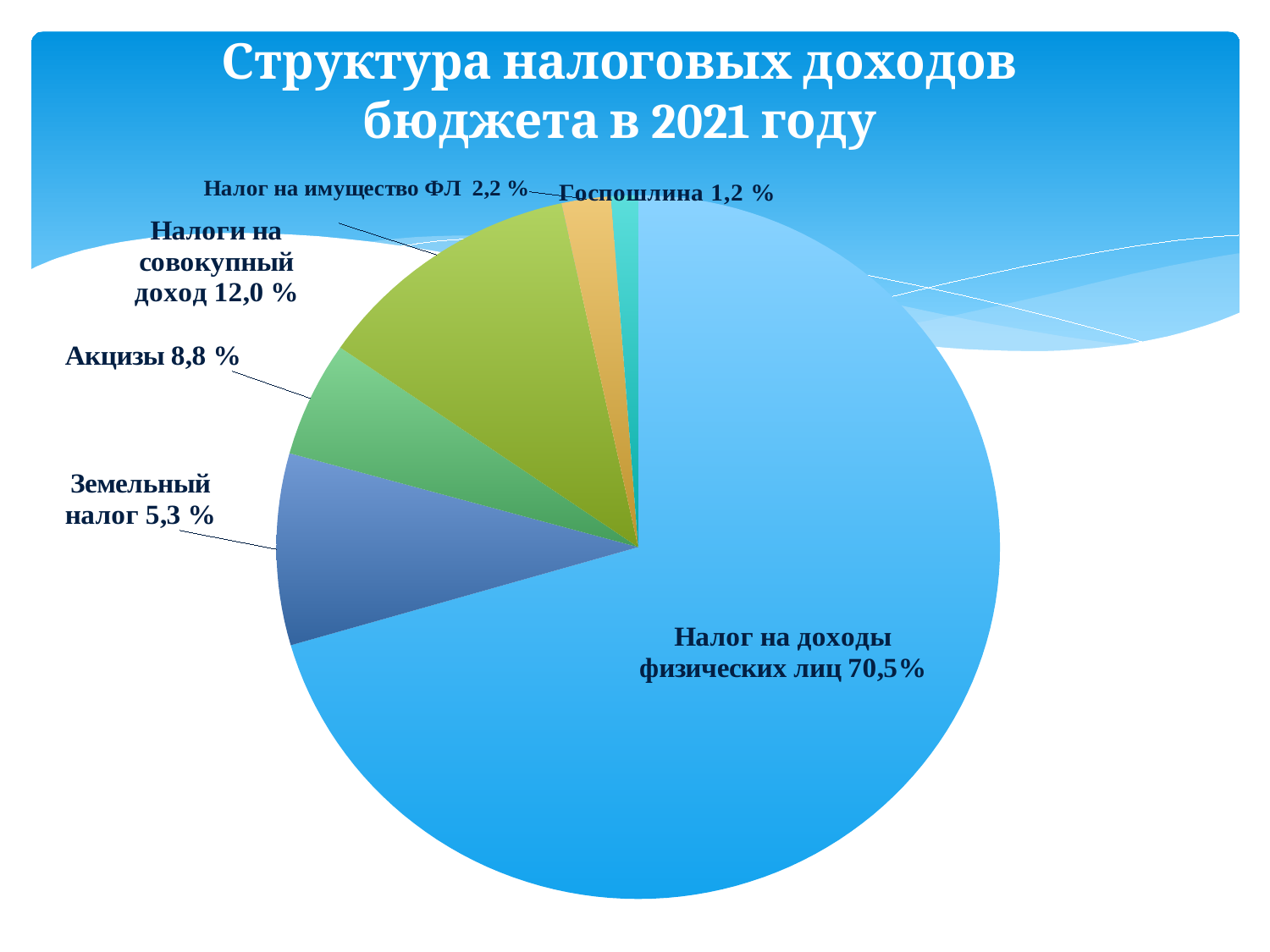
Which is larger: the share of Акцизы or the share of Земельный налог? Акцизы What is the title of the chart on the slide? Структура налоговых доходов бюджета в 2021 году What is the difference between the share of Налоги на совокупный доход and the share of Акцизы? 3,2 % Which category has the largest share of the pie? Налог на доходы физических лиц Which category has the smallest share of the pie? Госпошлина What is the share of Госпошлина? 1,2 % What is the share of Налог на доходы физических лиц in the pie chart? 70,5% How many slices does the pie chart have? 6 What type of chart is shown on the slide? Pie chart What is the share of Земельный налог? 5,3 % What is the share of Акцизы? 8,8 % What is the share of Налоги на совокупный доход? 12,0 %